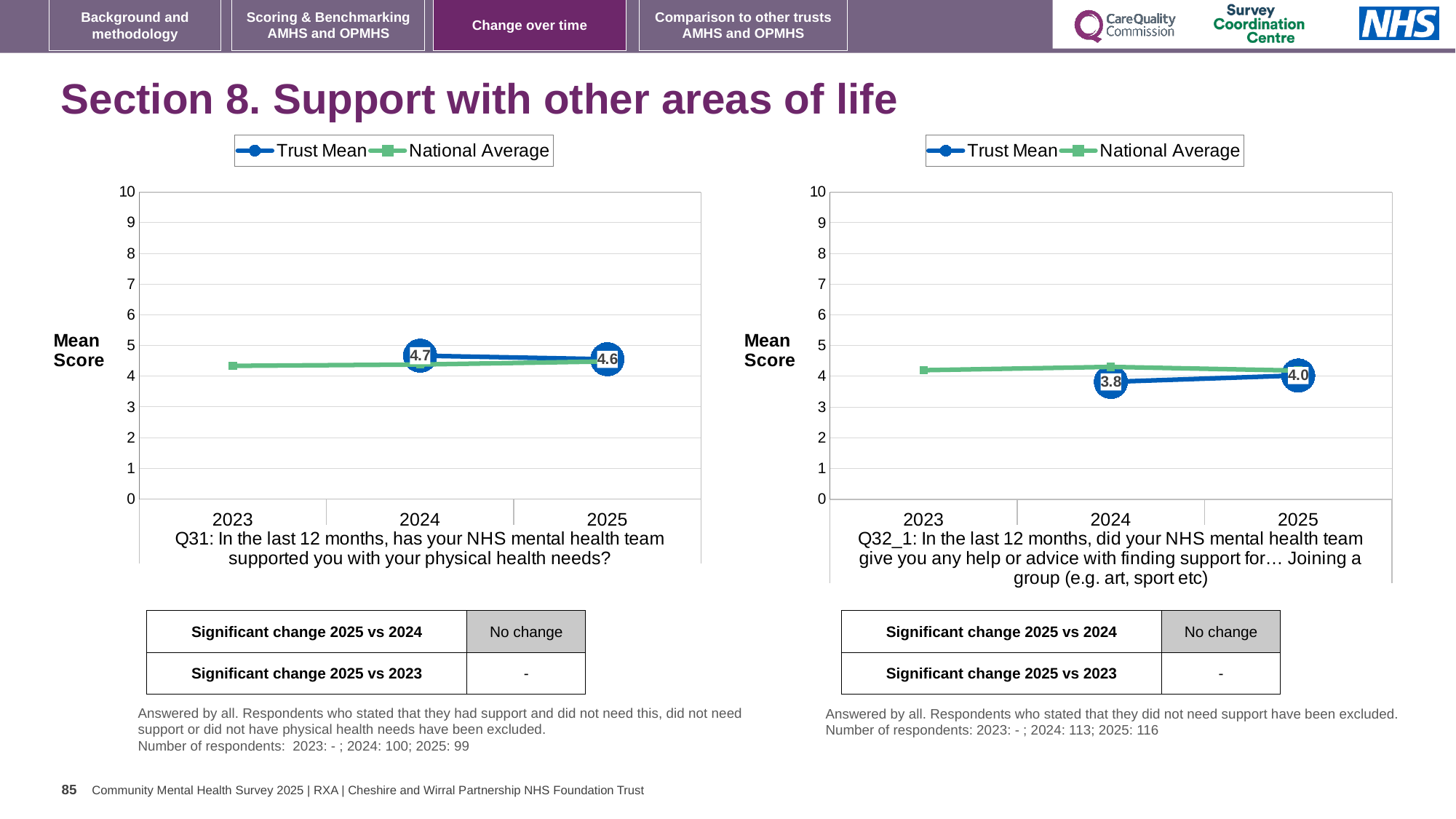
How many years are shown on the x axis of the Q32_1 chart (right)? 3 On the Q32_1 chart (right), what is the difference between the Trust Mean for 2025 and 2024? 0.2 On the Q32_1 chart (right), what is the Trust Mean for 2024? 3.8 On the Q32_1 chart (right), which year has the higher Trust Mean, 2024 or 2025? 2025 On the Q31 chart (left), what is the Trust Mean for 2025? 4.6 How many series does the legend list on the Q31 chart (left)? 2 On the Q31 chart (left), does the Trust Mean rise or fall from 2024 to 2025? fall On the Q31 chart (left), what is the difference between the Trust Mean for 2024 and 2025? 0.1 What kind of chart is the Q31 chart (left)? line chart On the Q32_1 chart (right), is the National Average for 2023 greater or less than 5? less On the Q32_1 chart (right), what is the Trust Mean for 2025? 4.0 On the Q31 chart (left), what is the Trust Mean for 2024? 4.7